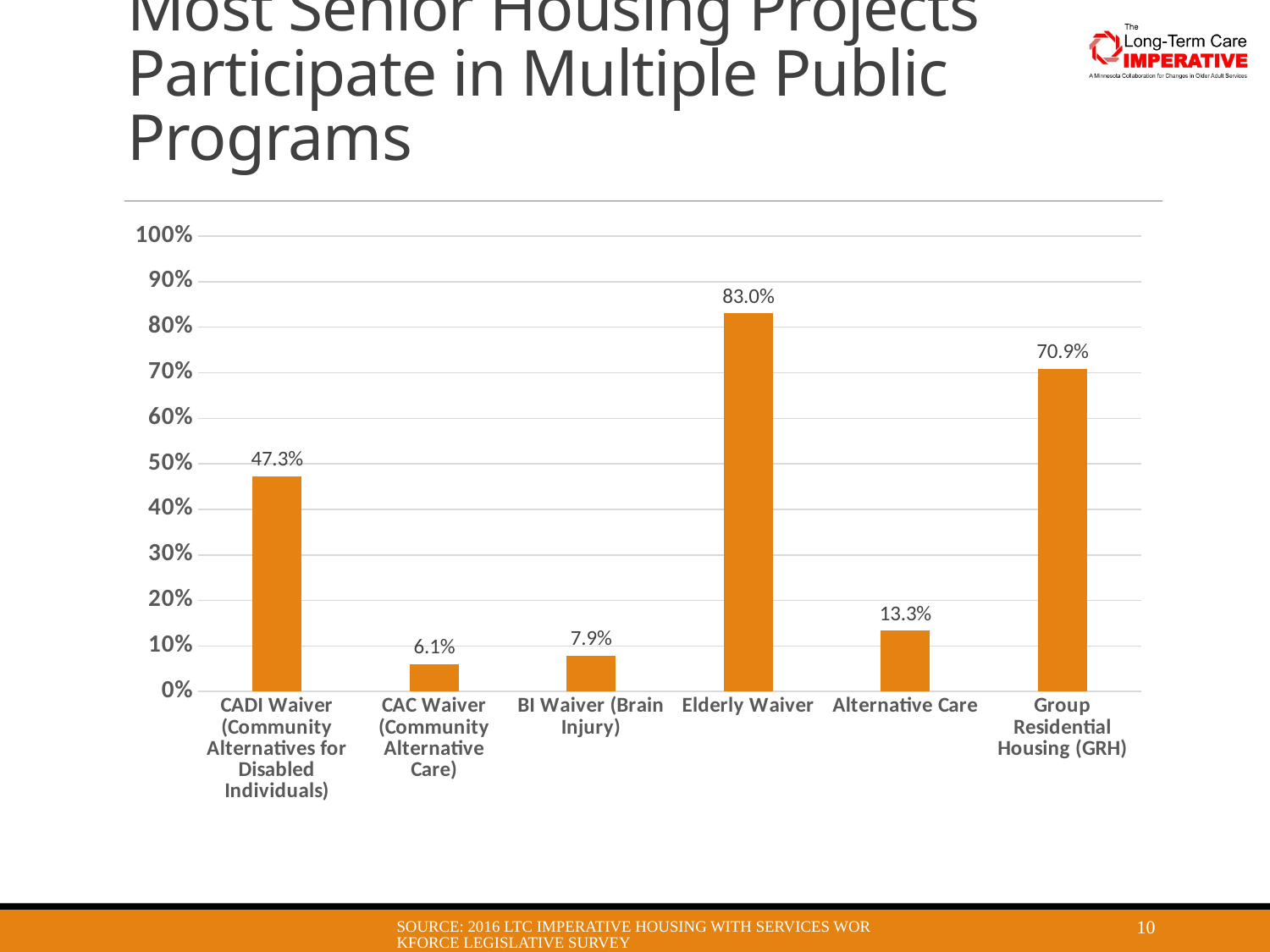
What is the value for Alternative Care? 13.3% What is the difference between the values for Elderly Waiver and Group Residential Housing (GRH)? 12.1% Is the value for CADI Waiver greater or less than 50%? less What is the value for Elderly Waiver? 83.0% What is the difference between the values for CADI Waiver and Alternative Care? 34.0% What kind of chart is shown on the slide? bar chart Which program has the lowest value? CAC Waiver (Community Alternative Care) How many programs are shown on the chart? 6 Which is larger, the value for BI Waiver (Brain Injury) or the value for CAC Waiver (Community Alternative Care)? BI Waiver (Brain Injury) What is the value for Group Residential Housing (GRH)? 70.9% What is the value for CAC Waiver (Community Alternative Care)? 6.1% Which program has the highest value? Elderly Waiver